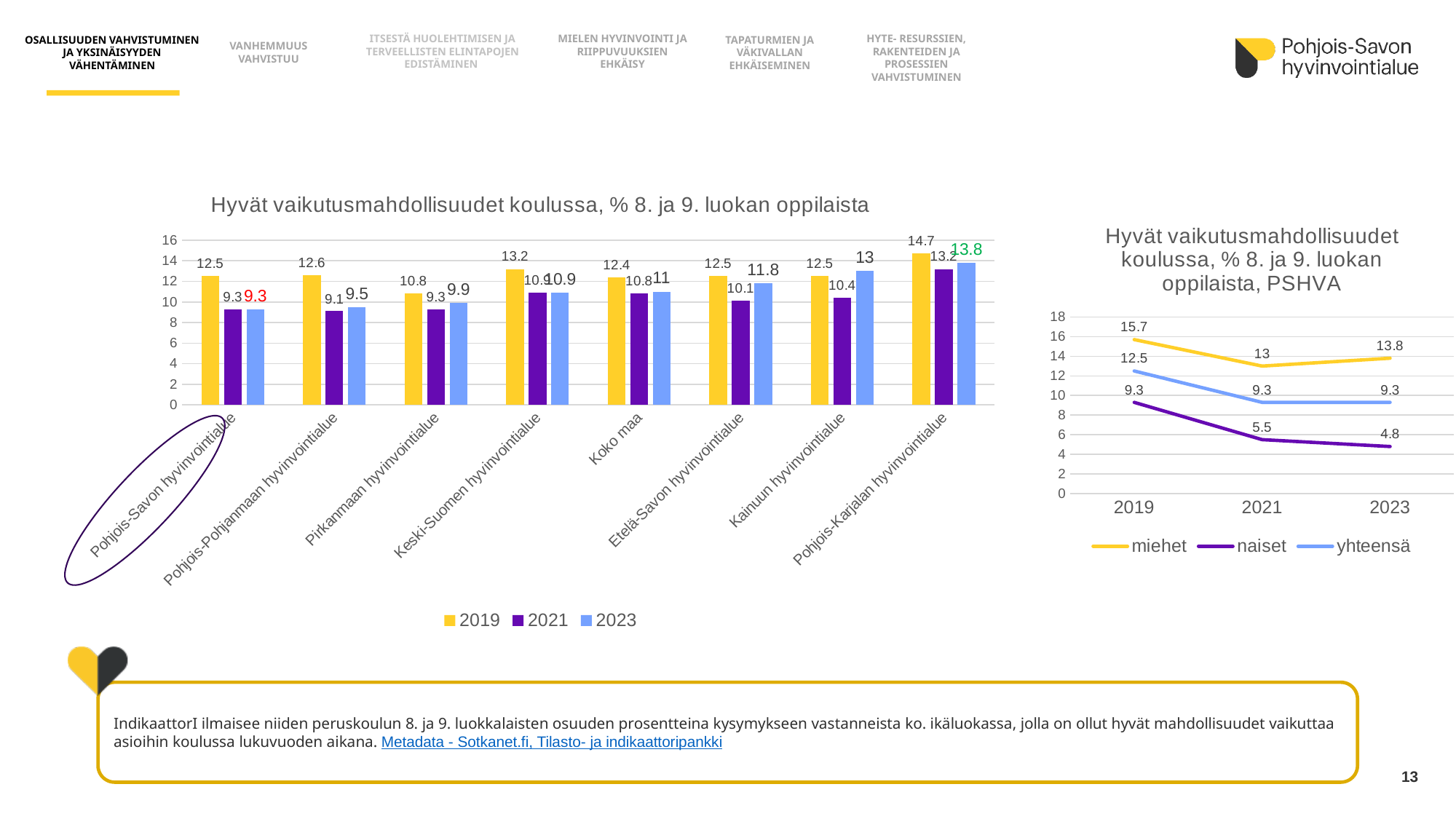
In the right line chart, what is the difference between the miehet and naiset values in 2019? 6.4 How many categories are shown on the x axis of the left bar chart? 8 How many series does the legend of the left chart list? 3 What kind of chart is the right chart titled 'Hyvät vaikutusmahdollisuudet koulussa, % 8. ja 9. luokan oppilaista, PSHVA'? line chart In the left chart 'Hyvät vaikutusmahdollisuudet koulussa, % 8. ja 9. luokan oppilaista', what is the 2019 value for Pohjois-Savon hyvinvointialue? 12.5 In the left bar chart, which category has the lowest 2023 value? Pohjois-Savon hyvinvointialue In the left bar chart, what is the difference between the 2019 and 2023 values for Pohjois-Savon hyvinvointialue? 3.2 In the left bar chart, which category has the highest 2019 value? Pohjois-Karjalan hyvinvointialue In the left bar chart, what is the 2023 value for Kainuun hyvinvointialue? 13 In the right line chart, what is the value for naiset in 2023? 4.8 In the left bar chart, which is larger for Etelä-Savon hyvinvointialue: the 2021 value or the 2023 value? 2023 In the right line chart, does the naiset series rise or fall from 2019 to 2023? fall